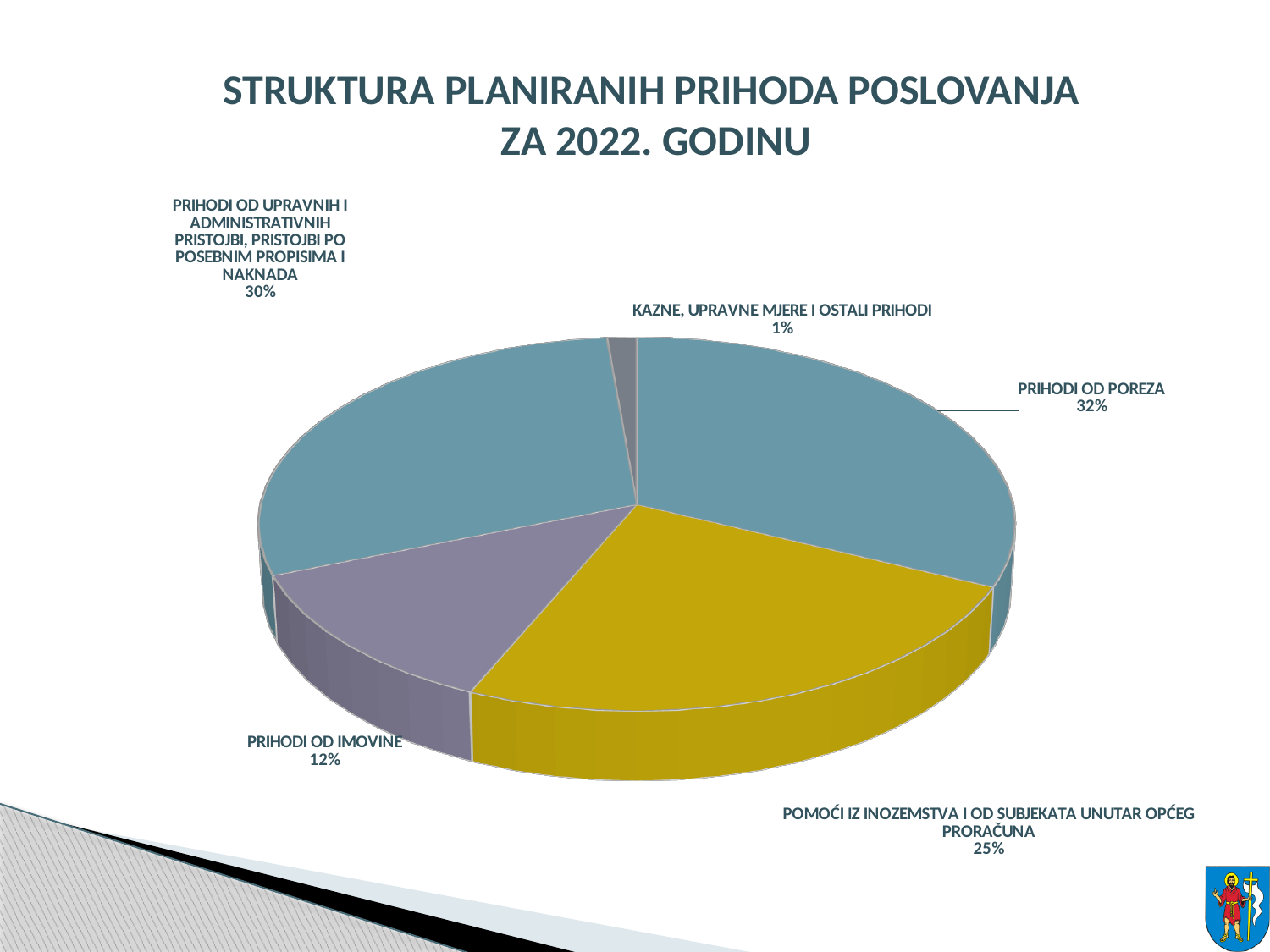
Which category has the smallest share of the pie? KAZNE, UPRAVNE MJERE I OSTALI PRIHODI What is the difference in percentage points between PRIHODI OD POREZA and PRIHODI OD IMOVINE? 20 What share of the pie is PRIHODI OD IMOVINE? 12% What share of the pie is KAZNE, UPRAVNE MJERE I OSTALI PRIHODI? 1% What share of the pie is POMOĆI IZ INOZEMSTVA I OD SUBJEKATA UNUTAR OPĆEG PRORAČUNA? 25% What kind of chart is shown on the slide? Pie chart Which is larger: the share for PRIHODI OD IMOVINE or the share for POMOĆI IZ INOZEMSTVA I OD SUBJEKATA UNUTAR OPĆEG PRORAČUNA? POMOĆI IZ INOZEMSTVA I OD SUBJEKATA UNUTAR OPĆEG PRORAČUNA Which category has the largest share of the pie? PRIHODI OD POREZA What is the title of the chart? STRUKTURA PLANIRANIH PRIHODA POSLOVANJA ZA 2022. GODINU How many slices does the pie chart have? 5